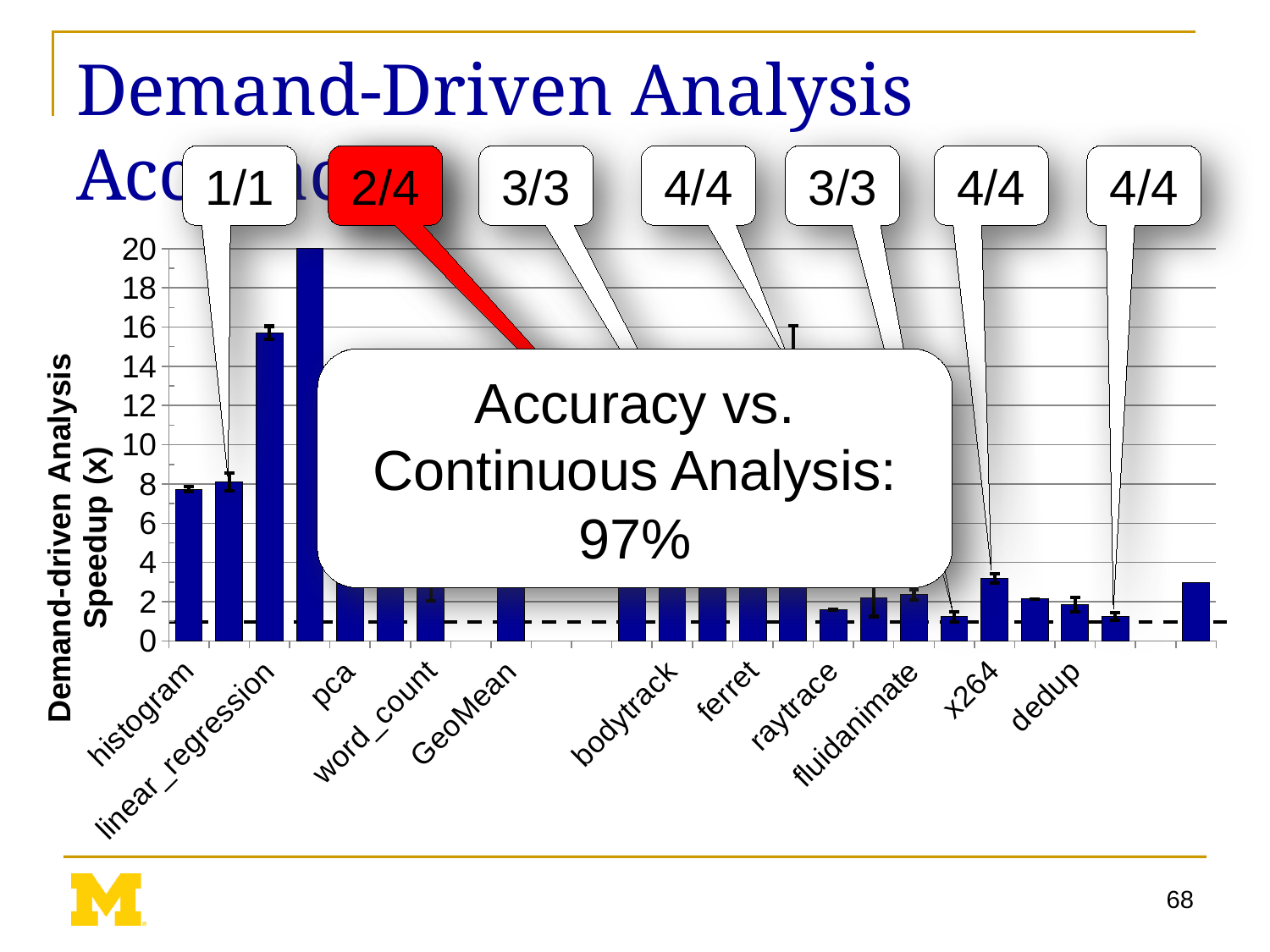
What kind of chart is shown on the slide? bar chart Which category is labelled last on the x axis of the chart? dedup How many category labels are printed along the x axis of the chart? 11 What is the highest value shown on the y axis of the chart? 20 Is the value for histogram greater or less than 10? less At what y-axis value is the horizontal dashed line drawn across the chart? 1 What is the title of the y axis of the chart? Demand-driven Analysis Speedup (x) Is the value for histogram greater or less than 6? greater Which category is labelled first on the x axis of the chart? histogram Is the tallest bar in the chart greater or less than 18? greater